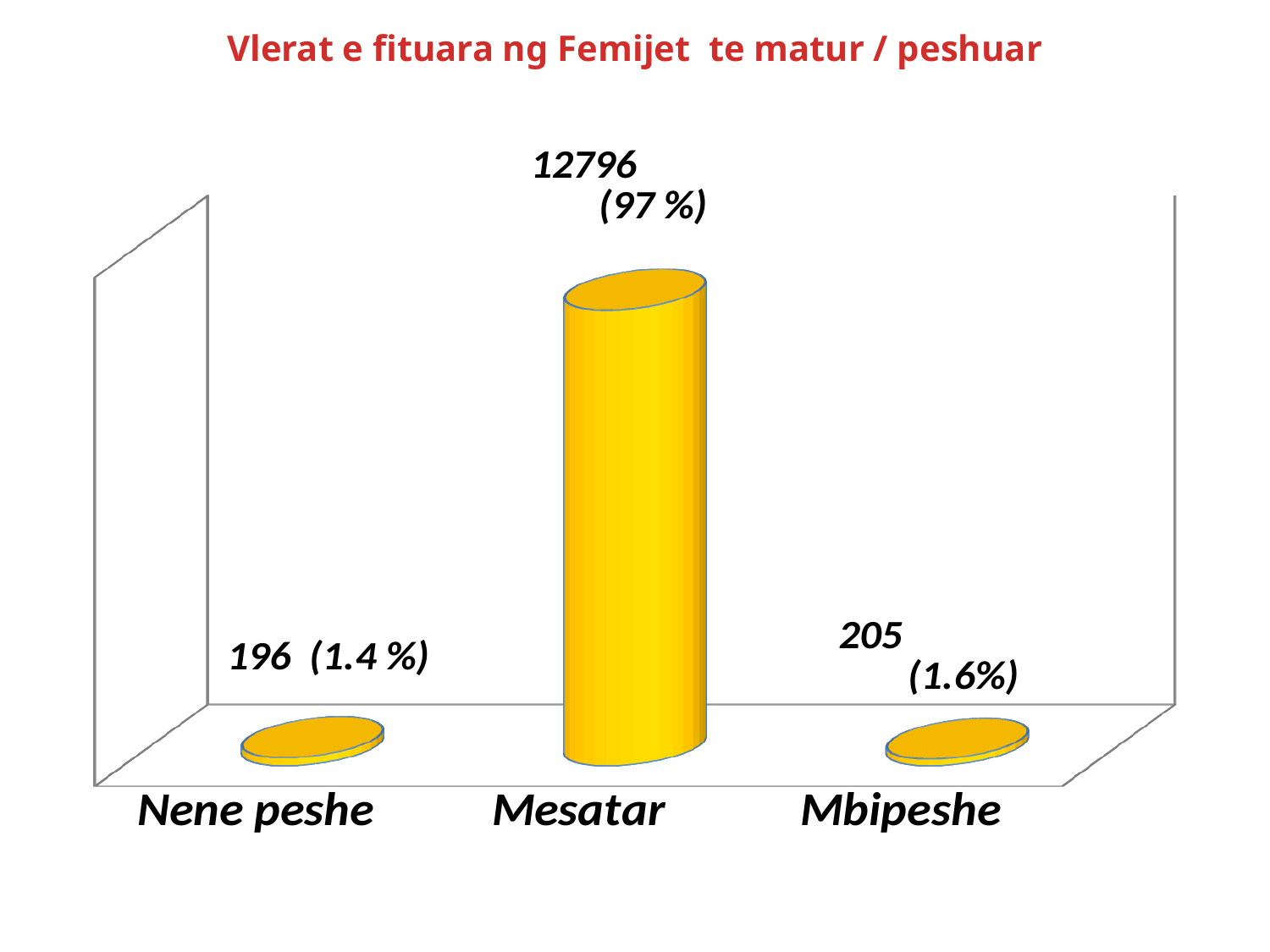
What percentage is shown for Mesatar? 97 % What is the value for Mbipeshe? 205 What is the value for Mesatar? 12796 How many categories are shown on the chart? 3 Which is larger, the value for Mbipeshe or the value for Nene peshe? Mbipeshe Which category has the lowest value? Nene peshe What kind of chart is shown on the slide? Bar chart What is the difference between the values for Mbipeshe and Nene peshe? 9 What percentage is shown for Mbipeshe? 1.6% What is the value for Nene peshe? 196 What is the difference between the values for Mesatar and Nene peshe? 12600 Which category has the highest value? Mesatar